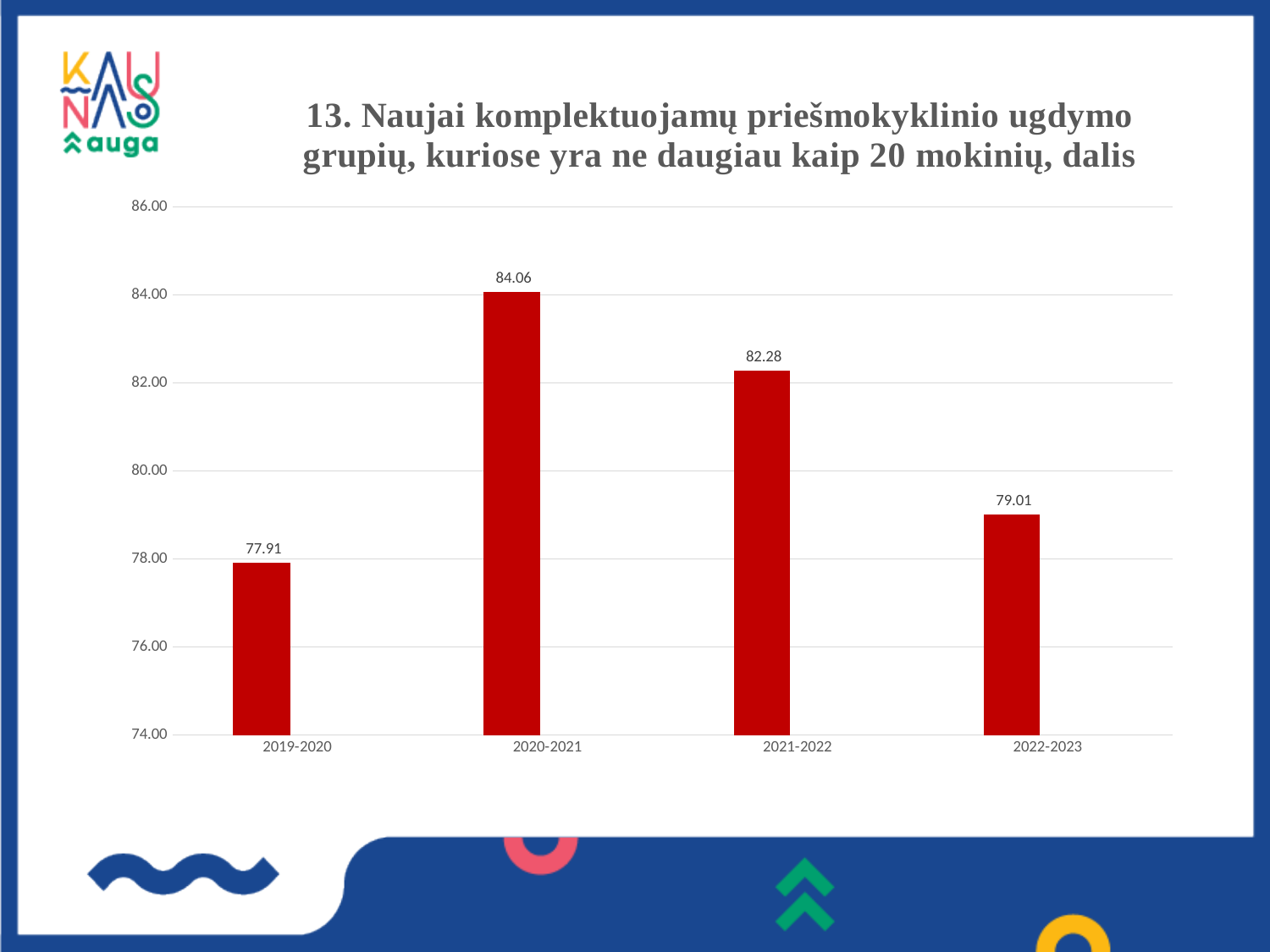
Is the value for 2022-2023 greater or less than 80.00? less Which year has the lowest value? 2019-2020 What is the value for 2020-2021? 84.06 How many years are shown on the x axis? 4 What is the value for 2022-2023? 79.01 Which year has the highest value? 2020-2021 Which is larger, the value for 2021-2022 or the value for 2022-2023? 2021-2022 What kind of chart is shown on the slide? bar chart What is the value for 2021-2022? 82.28 What is the value for 2019-2020? 77.91 What is the difference between the values for 2020-2021 and 2019-2020? 6.15 What is the difference between the values for 2021-2022 and 2022-2023? 3.27